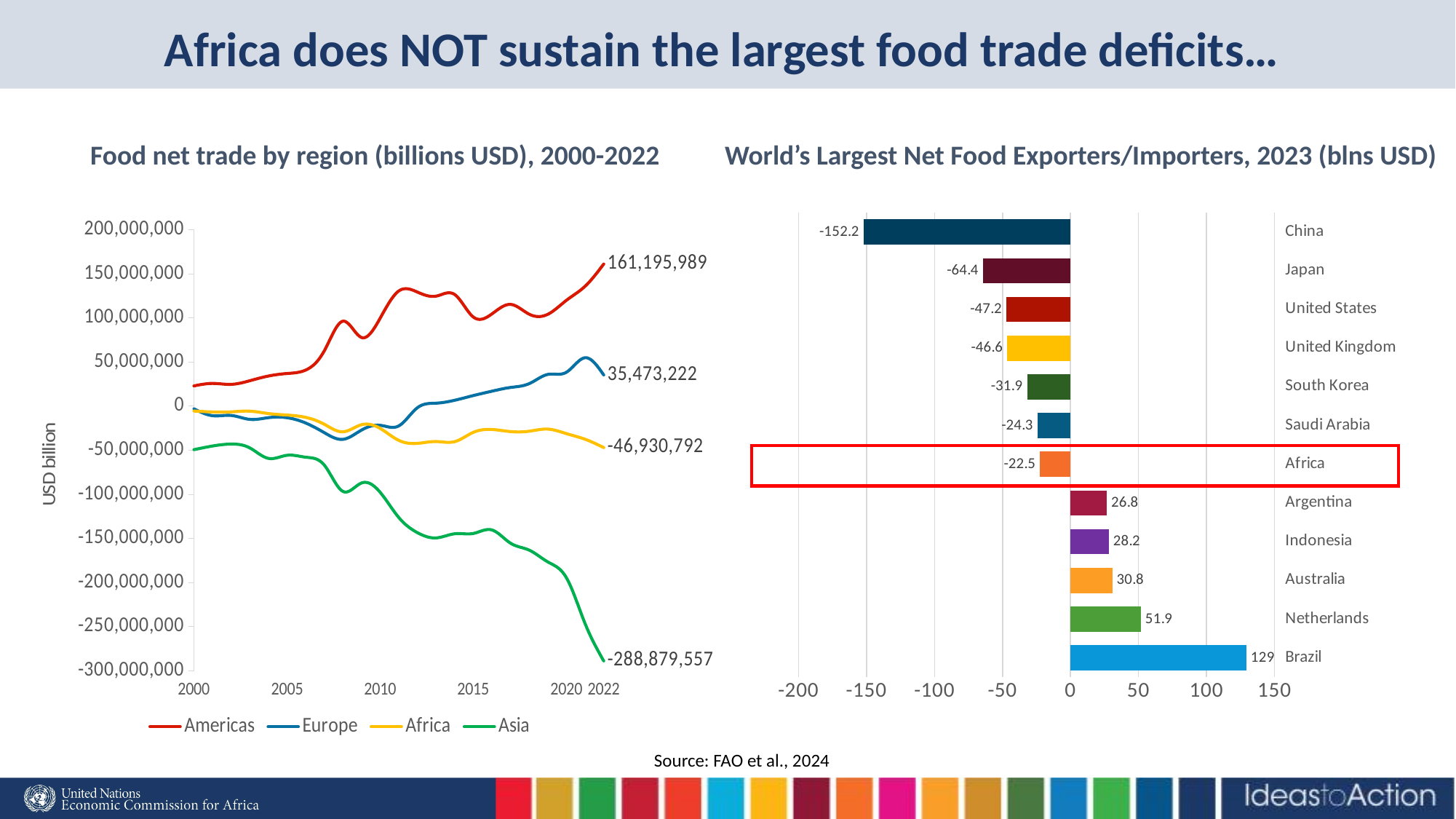
In the 'Food net trade by region' chart, does the Asia line rise or fall from 2000 to 2022? fall In the 'World's Largest Net Food Exporters/Importers' chart, what is the value for Africa? -22.5 In the 'World's Largest Net Food Exporters/Importers' chart, which is larger, the value for Australia or the value for Indonesia? Australia In the 'Food net trade by region' chart, what is the 2022 value for Asia? -288,879,557 In the 'World's Largest Net Food Exporters/Importers' chart, what is the value for China? -152.2 In the 'Food net trade by region' chart, how many series does the legend list? 4 In the 'World's Largest Net Food Exporters/Importers' chart, which country has the highest value? Brazil In the 'World's Largest Net Food Exporters/Importers' chart, what is the difference between the values for Brazil and the Netherlands? 77.1 In the 'Food net trade by region' chart, what is the 2022 value for the Americas? 161,195,989 In the 'World's Largest Net Food Exporters/Importers' chart, how many countries or regions are shown? 12 What kind of chart is the 'Food net trade by region' chart? line chart In the 'Food net trade by region' chart, what is the 2022 value for Africa? -46,930,792